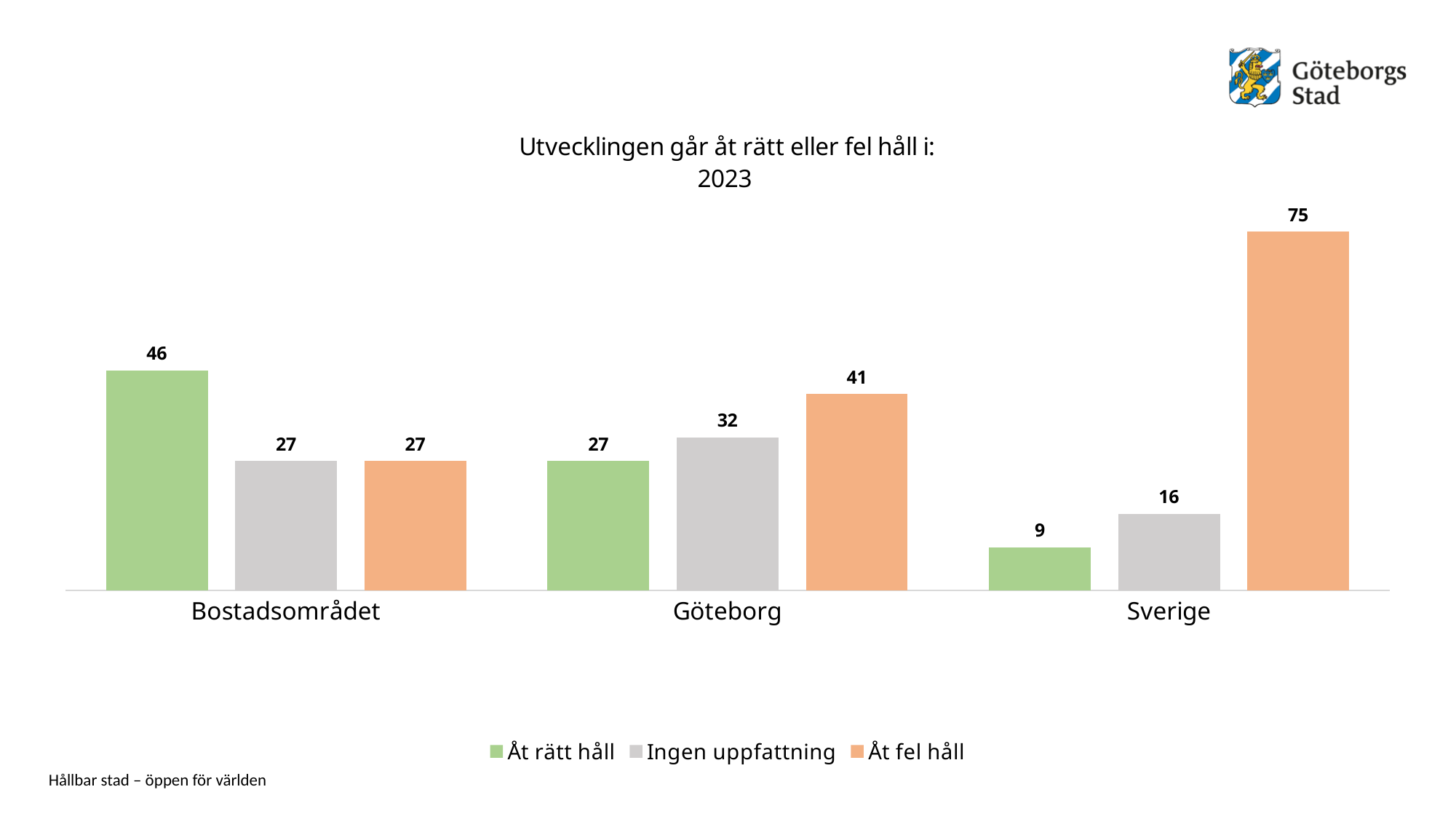
Which category has the highest value for "Åt fel håll"? Sverige How many series does the legend list? 3 What is the value for "Åt rätt håll" in Sverige? 9 What is the value for "Ingen uppfattning" in Göteborg? 32 What is the value for "Åt rätt håll" in Bostadsområdet? 46 Which is larger in Göteborg: "Åt rätt håll" or "Åt fel håll"? Åt fel håll What is the value for "Åt fel håll" in Sverige? 75 How many categories are shown on the x axis? 3 Which category has the lowest value for "Åt rätt håll"? Sverige What kind of chart is shown on the slide? Bar chart What colour represents "Ingen uppfattning" in the chart? Grey What is the difference between "Åt fel håll" and "Åt rätt håll" in Sverige? 66